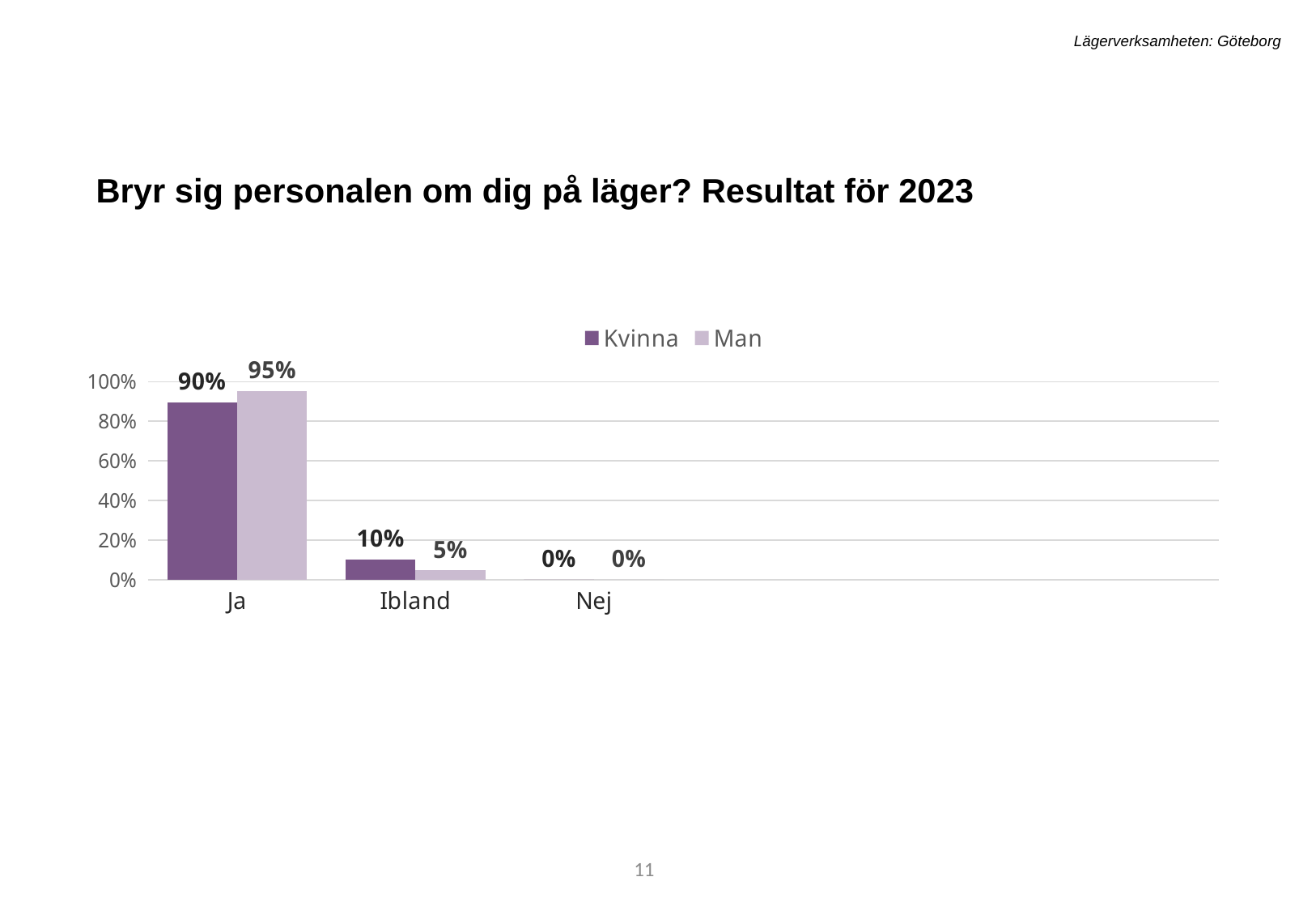
Which category has the lowest value for the Kvinna series? Nej What is the value for Man in the Ibland category? 5% Which category has the highest value for the Man series? Ja How many series does the legend list? 2 What is the value for Man in the Ja category? 95% What is the difference between the Man and Kvinna values in the Ja category? 5% What is the value for Kvinna in the Nej category? 0% In the Ibland category, which series has the larger value, Kvinna or Man? Kvinna How many categories are shown on the x axis? 3 What is the value for Kvinna in the Ibland category? 10% What is the value for Kvinna in the Ja category? 90% What kind of chart is shown on the slide? Bar chart